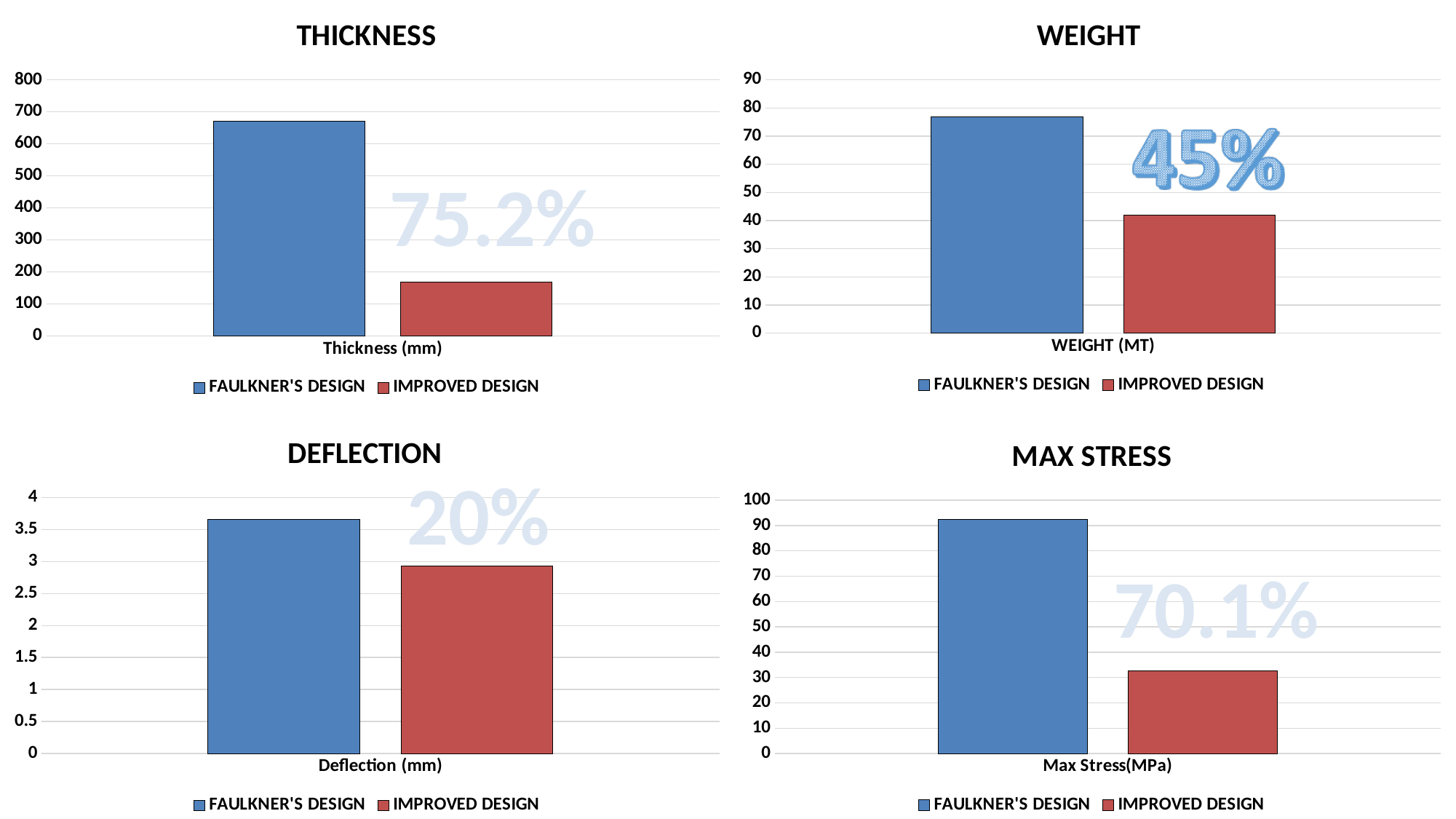
What percentage is printed over the WEIGHT chart? 45% In the MAX STRESS chart, which series has the higher value? FAULKNER'S DESIGN In the THICKNESS chart, is the value for IMPROVED DESIGN greater or less than 200? less In the WEIGHT chart, is the value for FAULKNER'S DESIGN greater or less than 70? greater In the DEFLECTION chart, is the value for FAULKNER'S DESIGN greater or less than 3.5? greater In the WEIGHT chart, how many series does the legend list? 2 In the THICKNESS chart, what kind of chart is shown? bar chart In the DEFLECTION chart, which series has the lower value? IMPROVED DESIGN In the THICKNESS chart, which series has the larger value, FAULKNER'S DESIGN or IMPROVED DESIGN? FAULKNER'S DESIGN